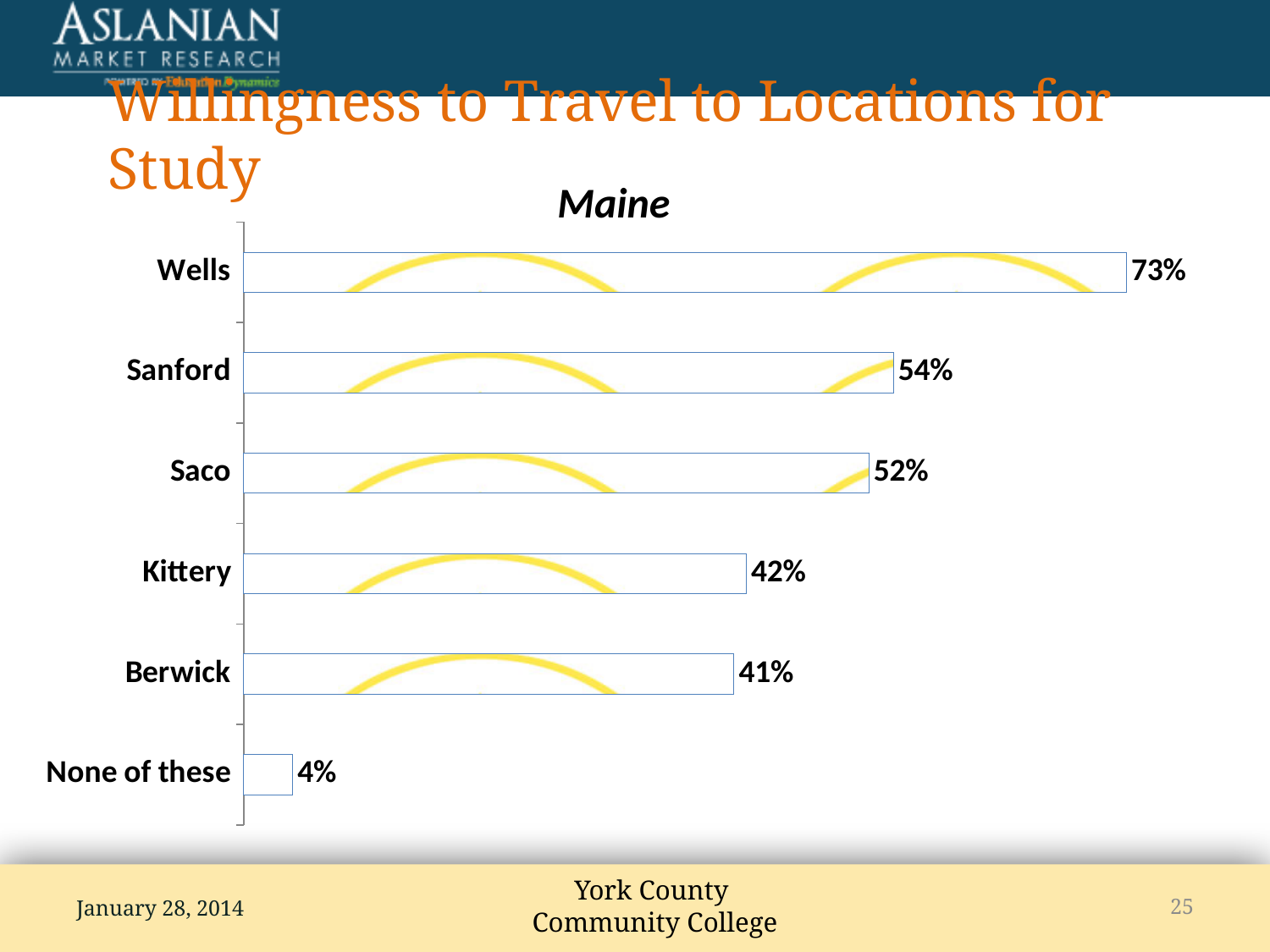
What is the difference between the values for Wells and Saco? 21% How many categories are shown on the chart? 6 What is the value shown for 'None of these'? 4% What percentage of respondents were willing to travel to Wells for study? 73% What is the title shown directly above the chart? Maine What is the value shown for Kittery? 42% Which has a larger value, Saco or Kittery? Saco What is the value shown for Sanford? 54% What is the difference between the values for Sanford and Berwick? 13% Which location has the highest willingness-to-travel percentage? Wells Which category has the lowest value on the chart? None of these What kind of chart is shown on the slide? Bar chart